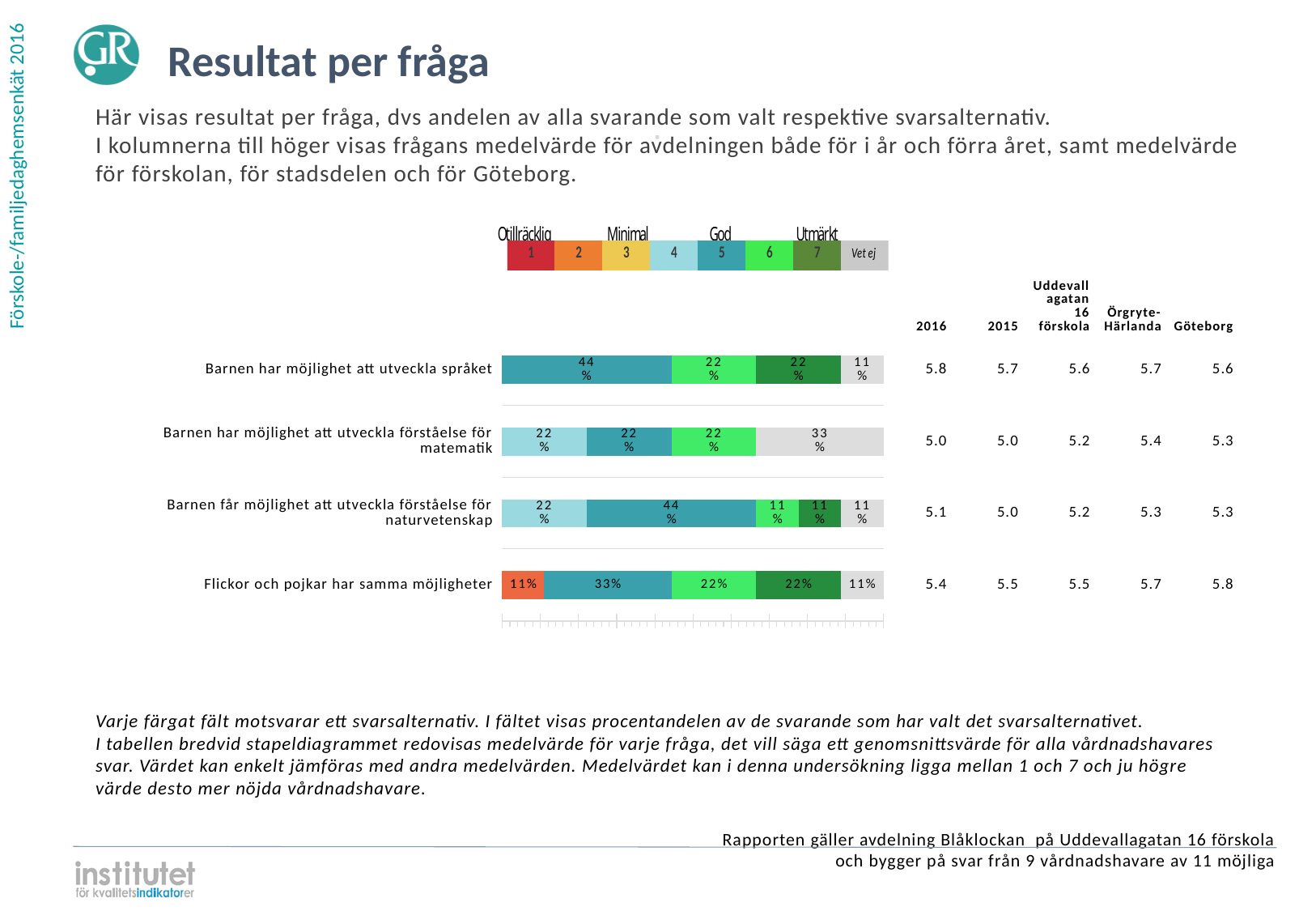
What is the difference between the share for alternative 5 and the share for alternative 6 in 'Barnen har möjlighet att utveckla språket'? 22% What percentage chose answer alternative 2 (orange) for 'Flickor och pojkar har samma möjligheter'? 11% How many answer alternatives does the legend above the chart list? 8 Which question has the lowest 2016 mean value in the table? Barnen har möjlighet att utveckla förståelse för matematik Which answer alternative has the largest share for 'Barnen får möjlighet att utveckla förståelse för naturvetenskap'? 5 What kind of chart is used to show the results per question? Stacked bar chart How many questions (categories) are shown in the bar chart? 4 For 'Flickor och pojkar har samma möjligheter', which is larger: the share for alternative 5 or the share for alternative 6? Alternative 5 What percentage of respondents chose answer alternative 5 (teal) for 'Barnen har möjlighet att utveckla språket'? 44% What is the combined share of alternatives 6 and 7 for 'Flickor och pojkar har samma möjligheter'? 44% What percentage chose 'Vet ej' for 'Barnen har möjlighet att utveckla förståelse för matematik'? 33% What is the 2016 mean value for 'Barnen har möjlighet att utveckla språket' in the table next to the chart? 5.8